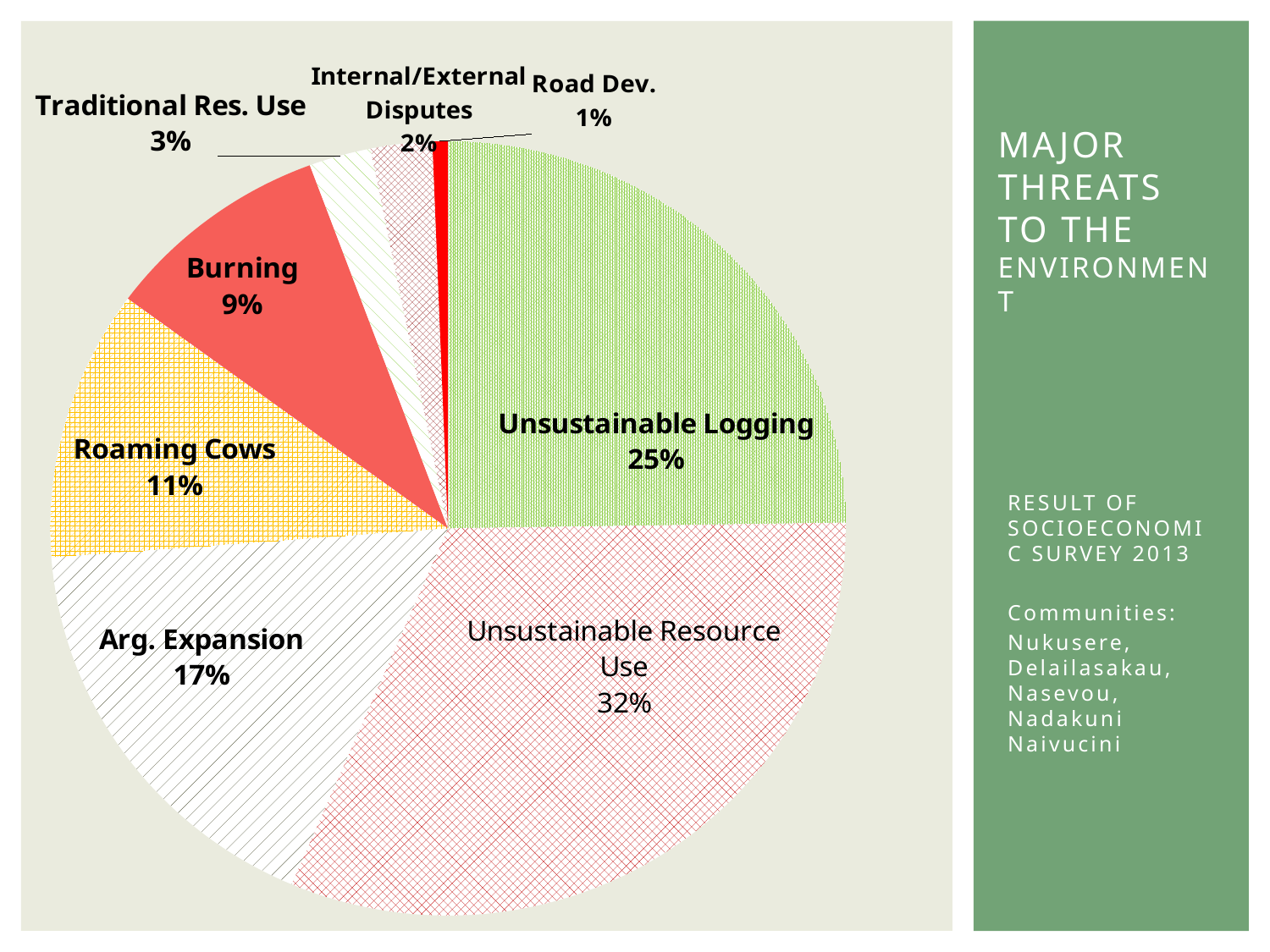
What is the value shown for Traditional Res. Use? 3% What colour is the Burning slice? Red What share of the pie does Unsustainable Resource Use account for? 32% What kind of chart is shown on the slide? Pie chart What is the difference between the Arg. Expansion and Burning percentages? 8% How many categories are shown in the pie chart? 8 Which category has the largest slice of the pie? Unsustainable Resource Use Which is larger, Roaming Cows or Burning? Roaming Cows What is the value shown for Unsustainable Logging? 25% What is the value shown for Roaming Cows? 11% Which category has the smallest slice of the pie? Road Dev. What is the combined share of Unsustainable Logging and Unsustainable Resource Use? 57%